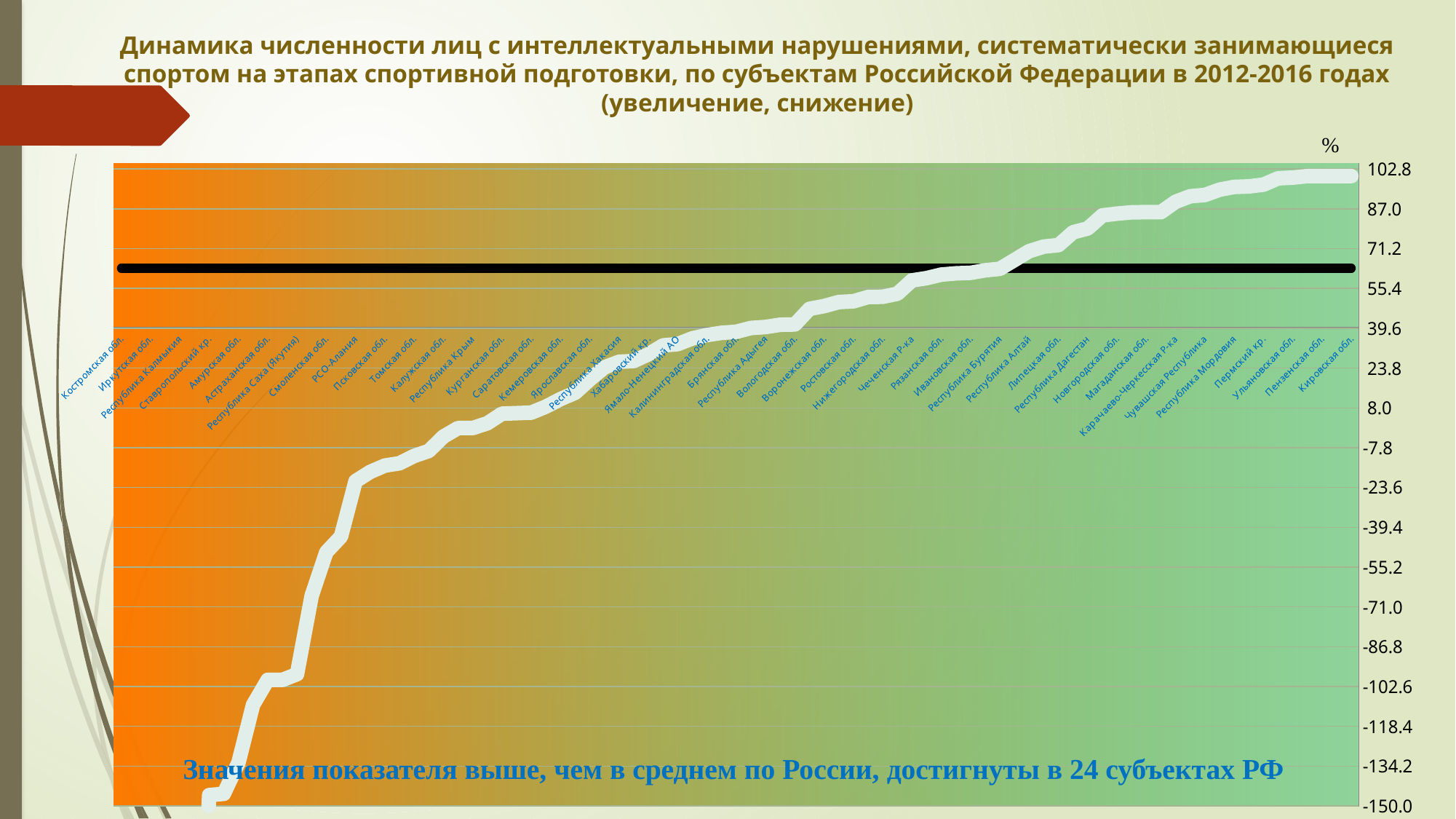
What unit is shown at the top of the value axis? % Is the value for Ямало-Ненецкий АО greater or less than 23.8? greater Which has the larger value, Псковская обл. or Пермский кр.? Пермский кр. What kind of chart is shown on the slide? line chart Is the value for Костромская обл. greater or less than -134.2? less According to the text on the chart, in how many subjects of the Russian Federation is the indicator above the Russian average? 24 Is the value for Республика Бурятия greater or less than 55.4? greater Which region has the lowest value on the chart? Костромская обл. Do the values rise or fall moving from left to right along the x axis? rise Which has the larger value, Иркутская обл. or Кировская обл.? Кировская обл.